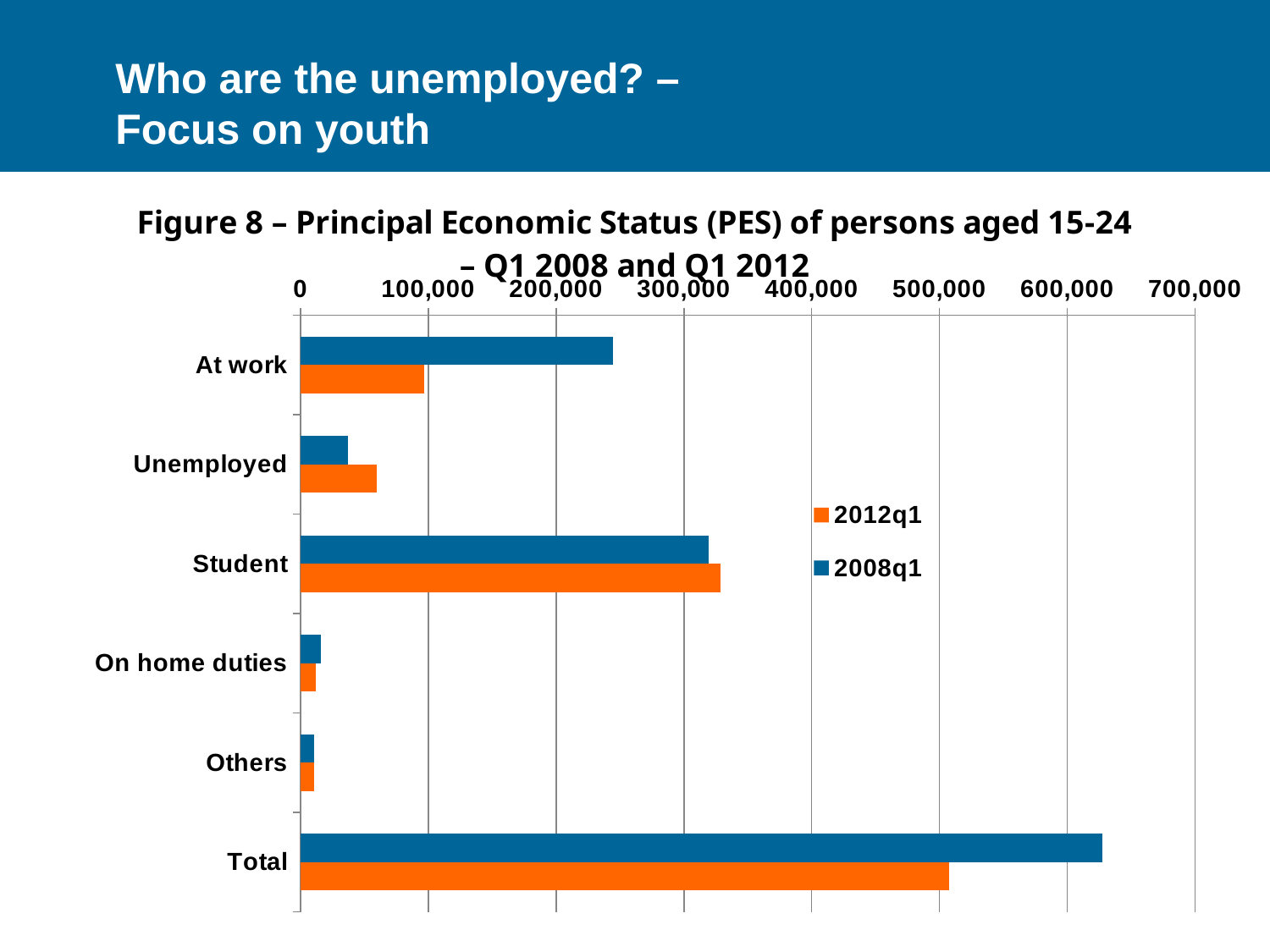
Which colour represents the 2012q1 series in the legend? orange Is the 2012q1 value for Unemployed greater or less than 100,000? less Which category has the shortest bar for 2008q1? Others For At work, which series has the larger value, 2008q1 or 2012q1? 2008q1 How many categories are shown on the vertical axis? 6 How many series does the legend list? 2 Which category has the longest bar for 2008q1? Total For Total, which series has the larger value, 2008q1 or 2012q1? 2008q1 Is the 2008q1 value for Total greater or less than 600,000? greater Is the 2008q1 value for At work greater or less than 200,000? greater What kind of chart is shown on the slide? bar chart For Unemployed, which series has the larger value, 2008q1 or 2012q1? 2012q1